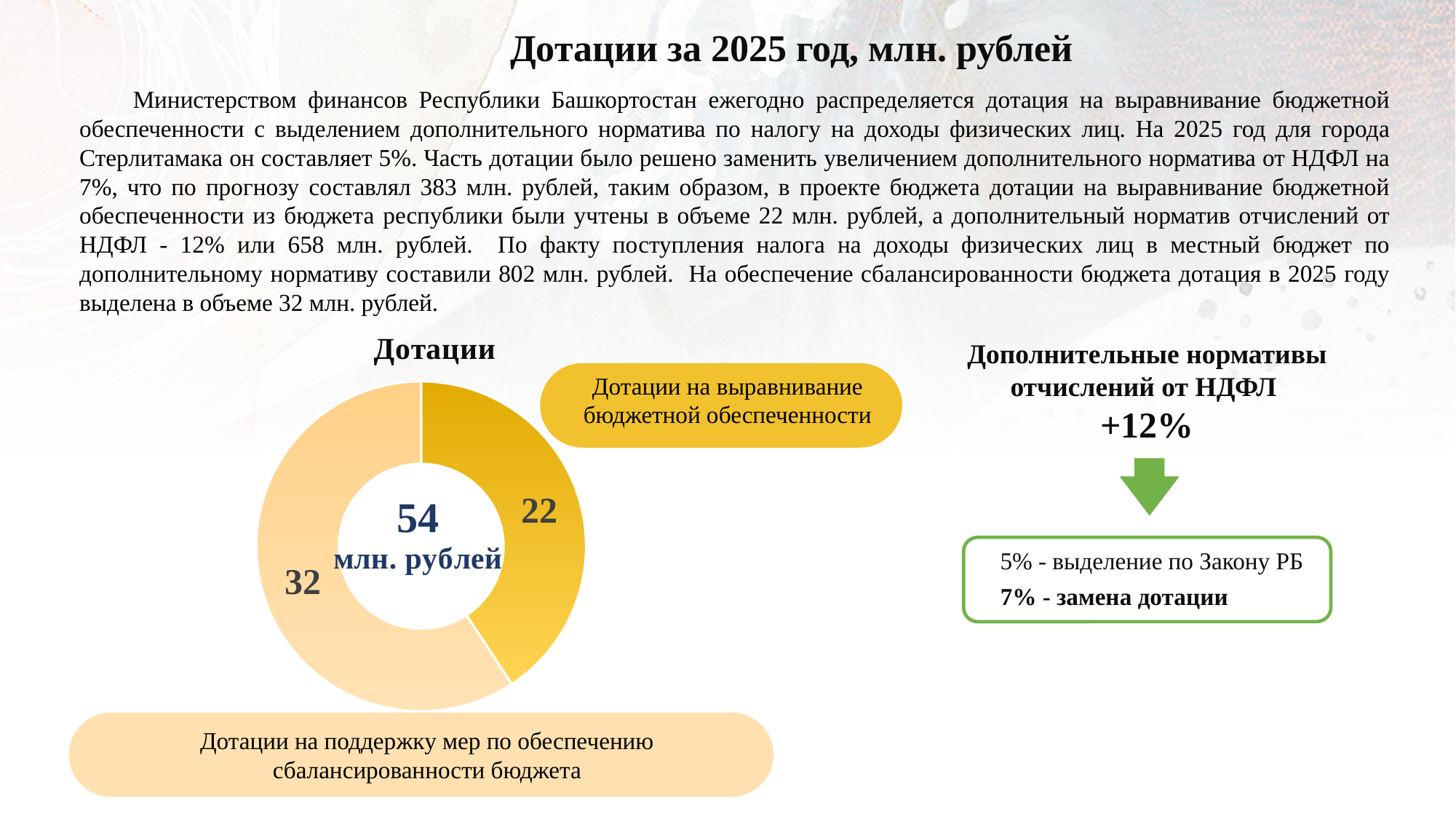
In the Дотации chart, which category has the smallest value? Дотации на выравнивание бюджетной обеспеченности What is the title of the chart on the slide? Дотации What kind of chart is the Дотации chart? Donut (pie) chart In the Дотации chart, which slice is shown in the darker gold colour? Дотации на выравнивание бюджетной обеспеченности How many slices does the Дотации chart have? 2 In the Дотации chart, what is the difference between the value for Дотации на поддержку мер по обеспечению сбалансированности бюджета and the value for Дотации на выравнивание бюджетной обеспеченности? 10 In the Дотации chart, what is the value for Дотации на выравнивание бюджетной обеспеченности? 22 In the Дотации chart, which is larger: Дотации на выравнивание бюджетной обеспеченности or Дотации на поддержку мер по обеспечению сбалансированности бюджета? Дотации на поддержку мер по обеспечению сбалансированности бюджета What total is shown in the centre of the Дотации chart? 54 млн. рублей In the Дотации chart, what is the value for Дотации на поддержку мер по обеспечению сбалансированности бюджета? 32 In the Дотации chart, which category has the largest value? Дотации на поддержку мер по обеспечению сбалансированности бюджета